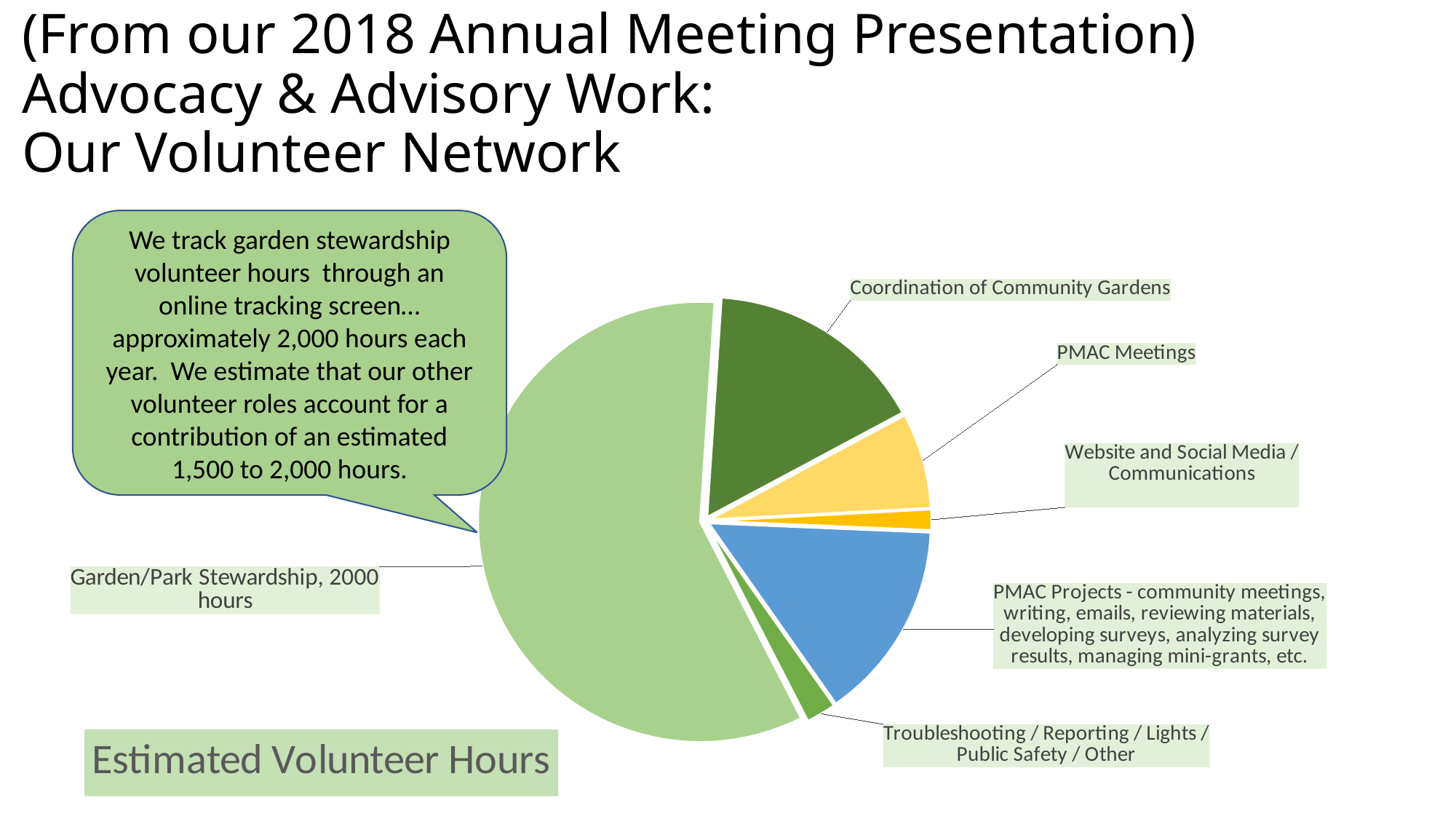
Which slice is larger: PMAC Projects or Troubleshooting / Reporting / Lights / Public Safety / Other? PMAC Projects What colour is the PMAC Projects slice of the pie chart? blue How many slices does the pie chart have? 6 What is the title of the pie chart? Estimated Volunteer Hours What kind of chart is shown on the slide? pie chart Which slice is larger: Coordination of Community Gardens or PMAC Meetings? Coordination of Community Gardens Which slice is larger: PMAC Projects or PMAC Meetings? PMAC Projects How many hours are shown for Garden/Park Stewardship? 2000 hours Which category has the largest slice of the pie chart? Garden/Park Stewardship